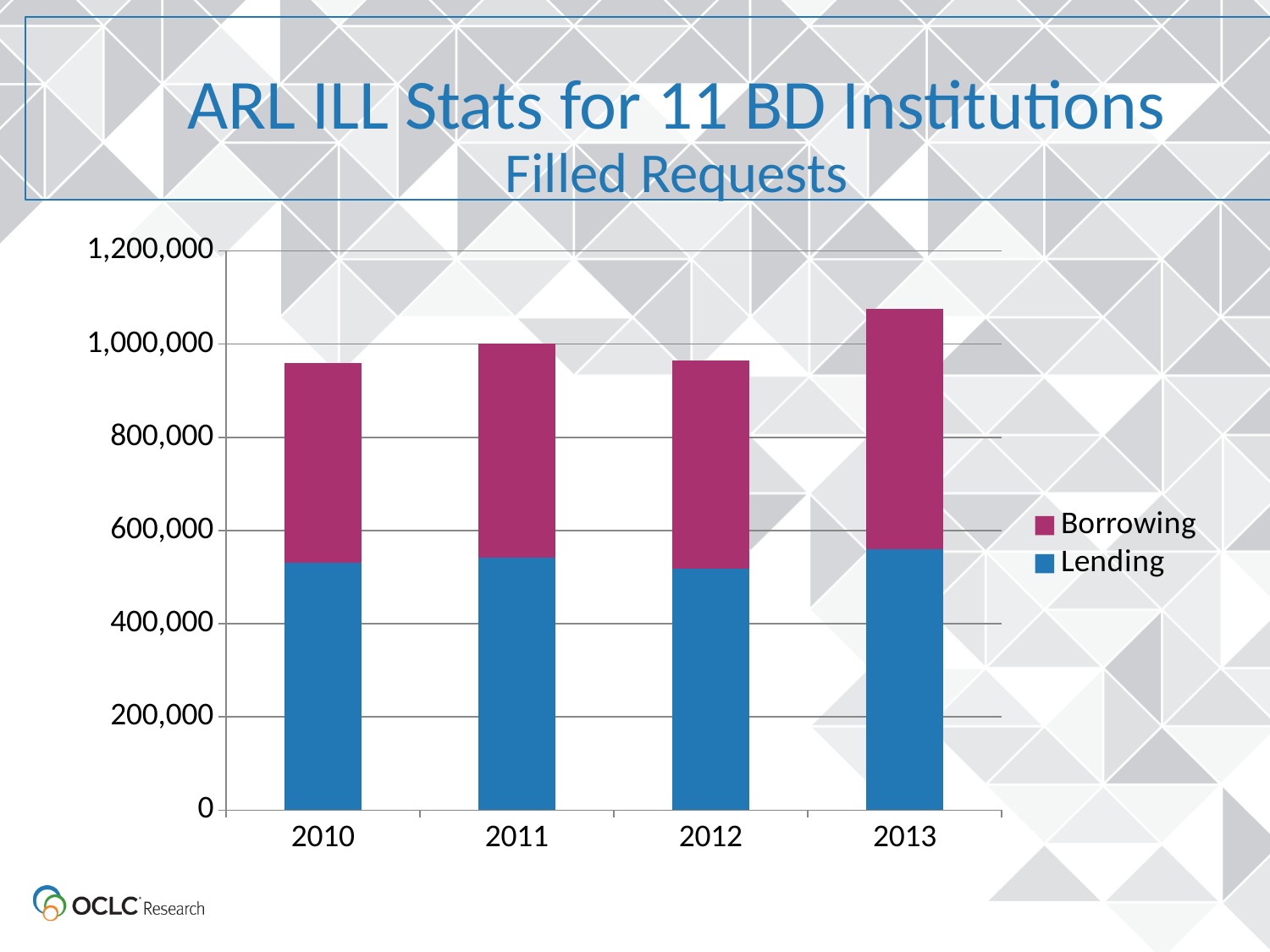
What kind of chart is shown on the slide? Stacked bar chart Which series is shown in blue in the chart? Lending Does the total of filled requests rise or fall from 2012 to 2013? rise Is the Lending value for 2013 greater or less than 600,000? less Which year has the highest total of filled requests? 2013 How many series does the chart's legend list? 2 Is the Lending value for 2010 greater or less than 400,000? greater Is the total of filled requests for 2010 greater or less than 1,000,000? less What is the title of the chart on the slide? ARL ILL Stats for 11 BD Institutions Filled Requests Which is larger, the total of filled requests for 2013 or for 2010? 2013 How many years are shown on the x axis of the chart? 4